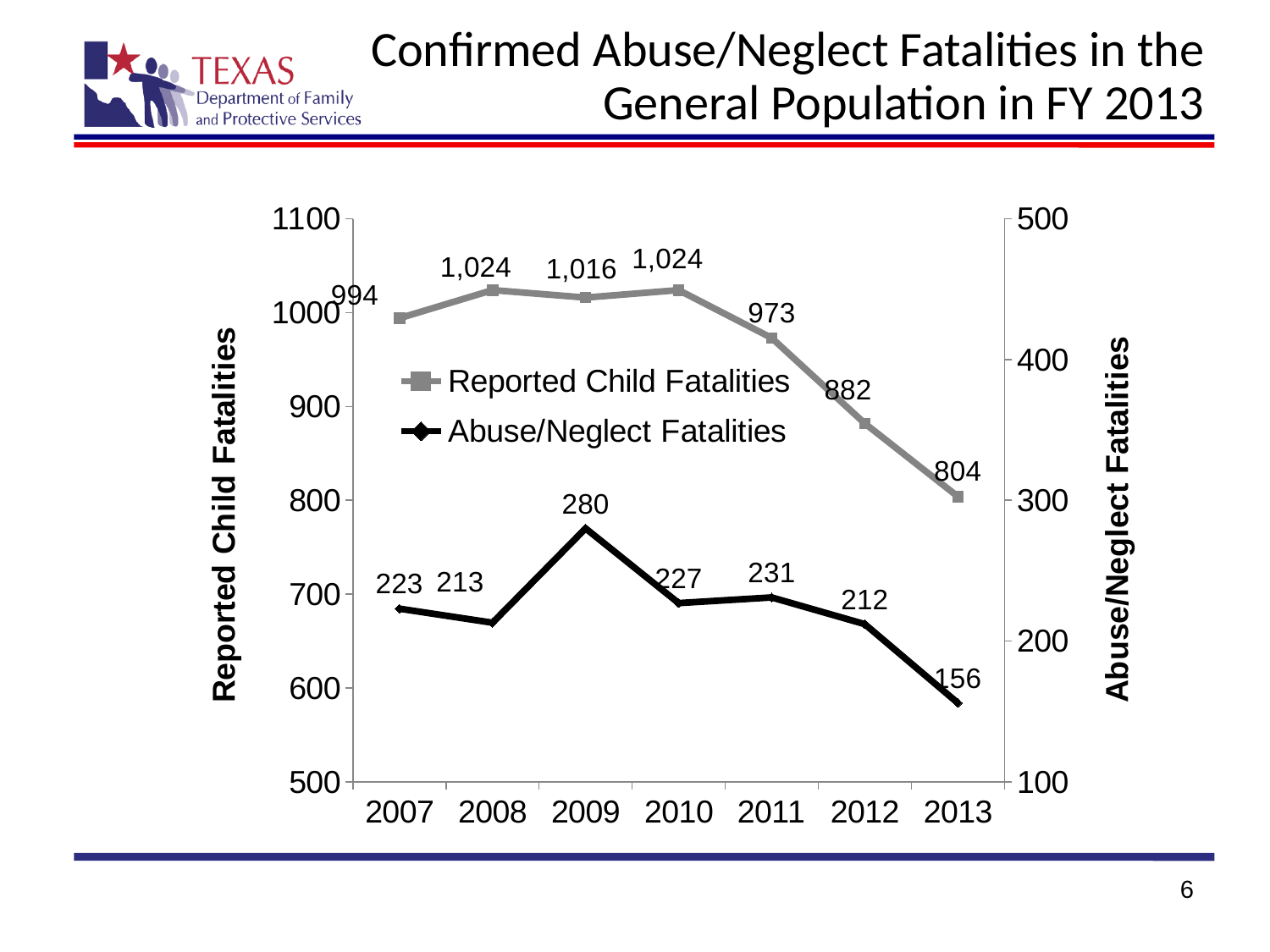
What kind of chart is shown on the slide? Line chart What was the number of Reported Child Fatalities in 2011? 973 In which year were Abuse/Neglect Fatalities highest? 2009 What was the number of Reported Child Fatalities in 2007? 994 Which year had more Abuse/Neglect Fatalities, 2010 or 2011? 2011 How many years are shown on the x axis? 7 Do Reported Child Fatalities rise or fall from 2010 to 2013? Fall In which year were Reported Child Fatalities lowest? 2013 What was the number of Abuse/Neglect Fatalities in 2013? 156 What is the label of the right-hand vertical axis? Abuse/Neglect Fatalities What is the difference between Reported Child Fatalities in 2012 and 2013? 78 How many series does the legend list? 2